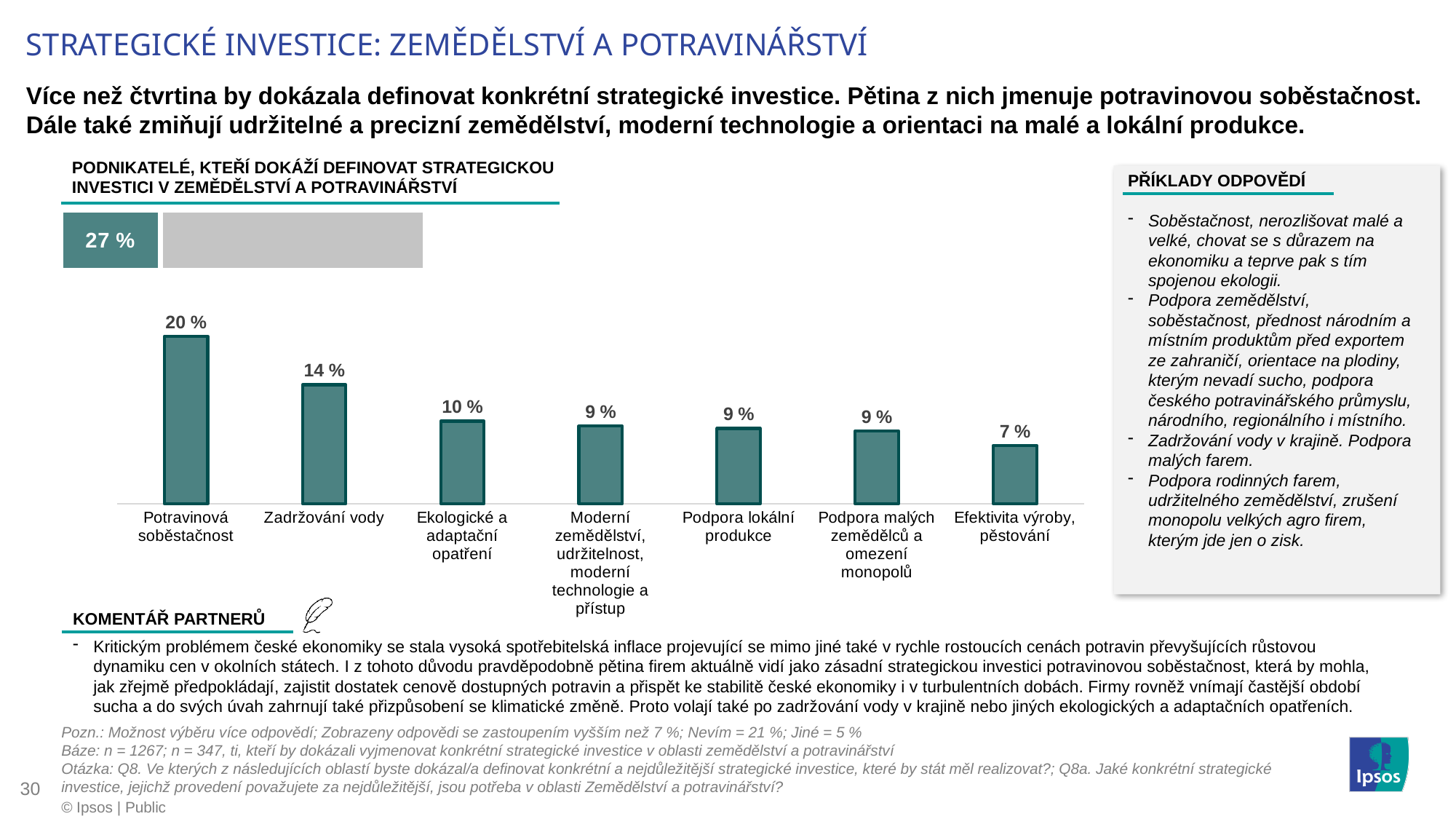
What percentage is shown in the small horizontal bar above the bar chart? 27 % In the bar chart, what is the difference between Potravinová soběstačnost and Zadržování vody? 6 % In the bar chart, what is the value for Efektivita výroby, pěstování? 7 % What kind of chart is the main chart on the slide? Bar chart Do the values in the bar chart rise or fall from left to right? Fall In the bar chart, what is the value for Potravinová soběstačnost? 20 % In the bar chart, what is the value for Ekologické a adaptační opatření? 10 % In the bar chart, what is the value for Zadržování vody? 14 % In the bar chart, which is larger: Zadržování vody or Podpora lokální produkce? Zadržování vody In the bar chart, which category has the lowest value? Efektivita výroby, pěstování How many categories does the bar chart show? 7 In the bar chart, which category has the highest value? Potravinová soběstačnost